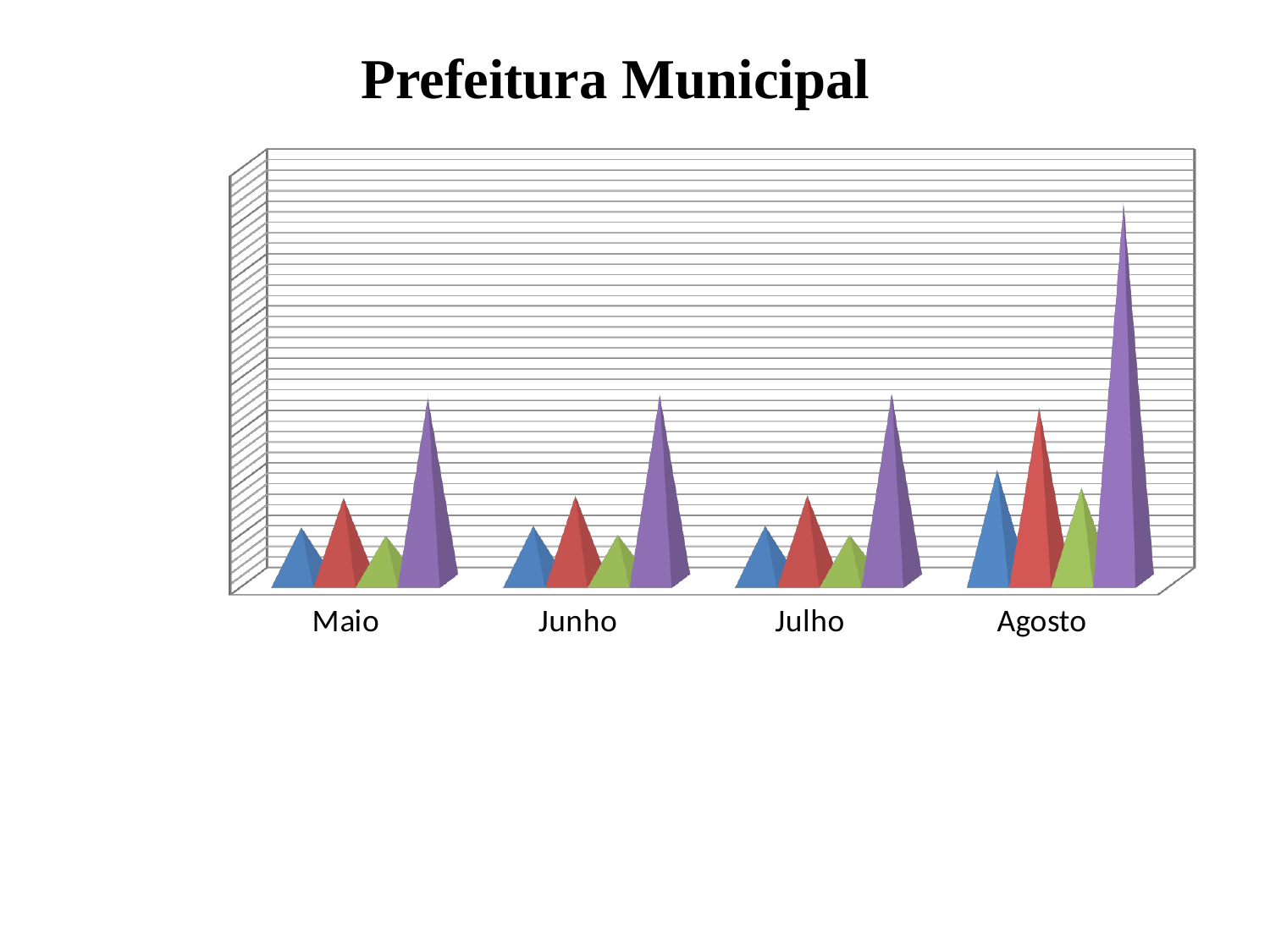
Which month has the tallest purple bar? Agosto Which month has the tallest red bar? Agosto In Agosto, which is taller: the green bar or the red bar? the red bar How many categories are shown on the x axis of the chart? 4 Which month has the tallest bar in the chart? Agosto What colour is the tallest bar in the chart? purple In Maio, which is taller: the blue bar or the red bar? the red bar What kind of chart is shown on the slide? bar chart How many bars are plotted for each month in the chart? 4 What is the title shown above the chart? Prefeitura Municipal Is the purple bar for Agosto taller or shorter than the purple bar for Maio? taller